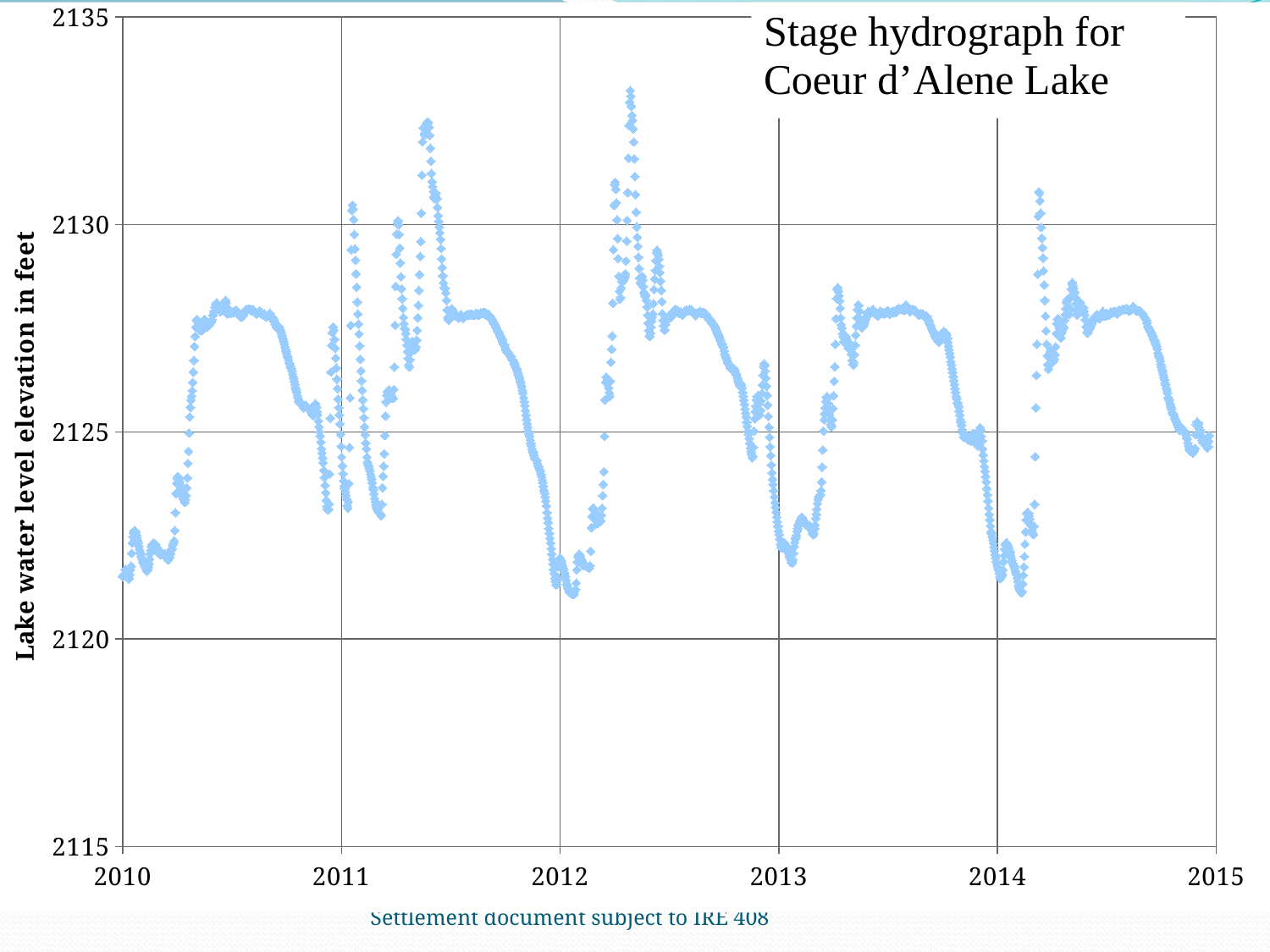
Is the lowest lake level reached at the start of 2012 greater or less than 2125? less Is the highest lake level reached in 2012 greater or less than 2130? greater What is the first year shown on the horizontal axis? 2010 Is the lake level at the start of 2010 greater or less than 2125? less What is the title of the chart? Stage hydrograph for Coeur d'Alene Lake What is the last year shown on the horizontal axis? 2015 What is the label of the vertical axis? Lake water level elevation in feet What is the lowest value shown on the vertical axis? 2115 What kind of chart is shown on the slide? Scatter plot What is the highest value shown on the vertical axis? 2135